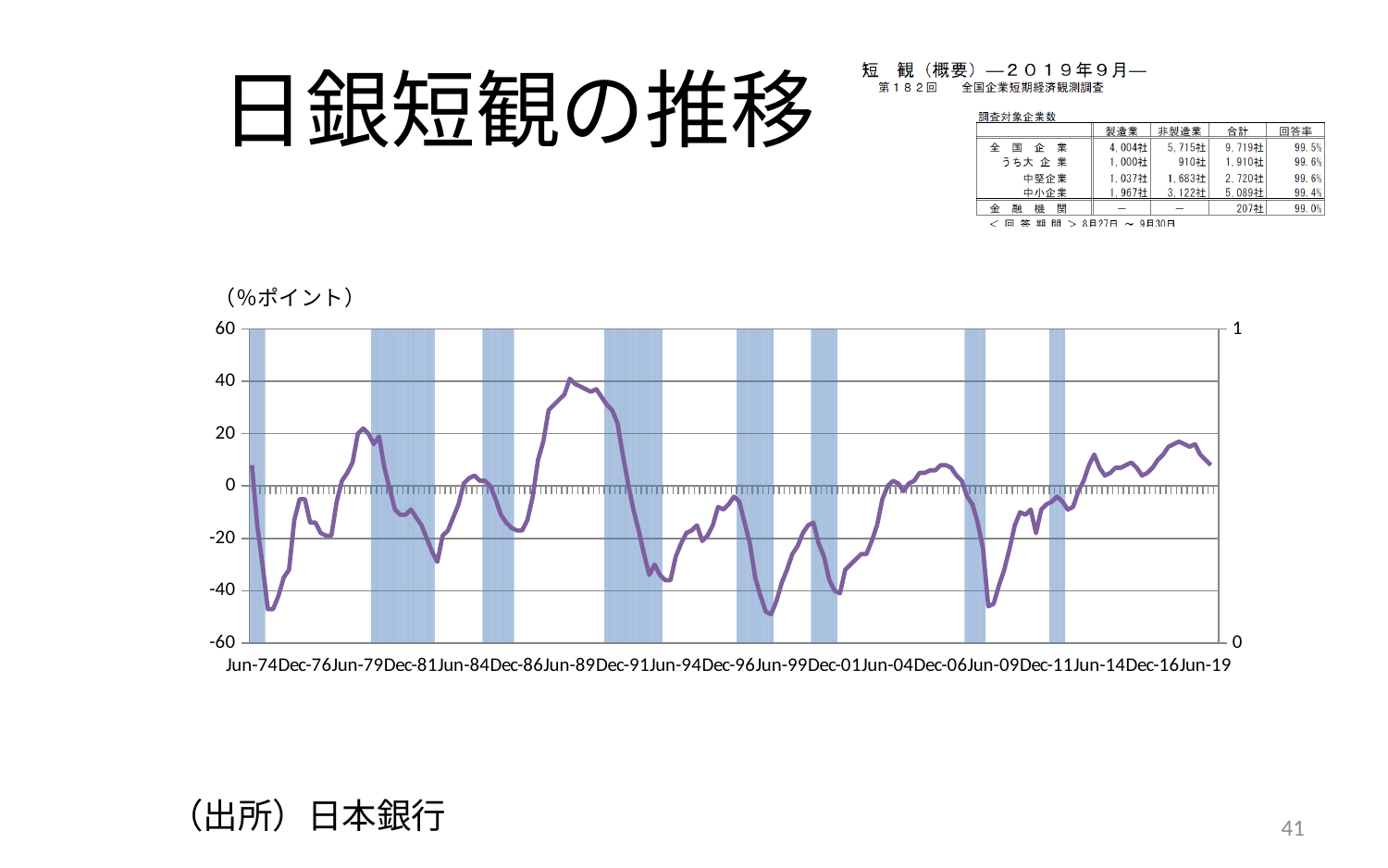
Is the value of the line at Jun-19 greater or less than 0? greater What is the first date label on the x axis? Jun-74 Is the peak of the line around Jun-89 to Dec-91 greater or less than 20? greater What kind of chart is shown on the slide? line chart How many shaded vertical bands are drawn on the chart? 8 What unit label is shown above the left axis of the chart? （%ポイント） What is the title of the slide's chart? 日銀短観の推移 What is the lowest value shown on the left vertical axis? -60 What is the highest value shown on the left vertical axis? 60 Does the line rise or fall between Jun-09 and Jun-14? rise Is the trough of the line around Jun-09 greater or less than -40? less What is the last date label on the x axis? Jun-19